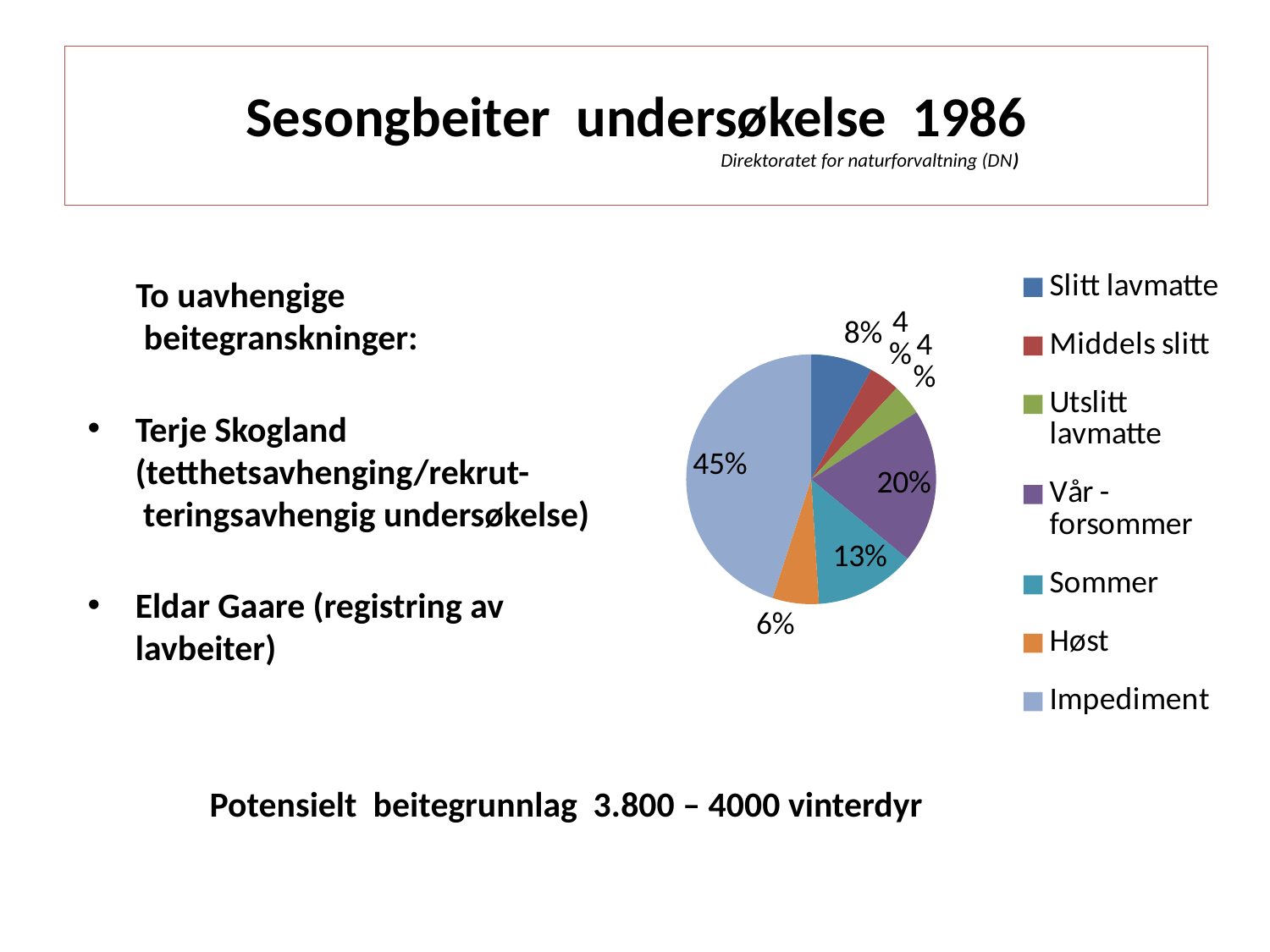
How many categories does the legend list? 7 What is the value shown for Sommer? 13% Which legend entry is shown in orange? Høst Which category has the largest slice of the pie? Impediment What share of the pie does Impediment represent? 45% What is the value shown for Vår - forsommer? 20% What is the value shown for Slitt lavmatte? 8% Which is larger, the Sommer slice or the Høst slice? Sommer What is the combined share of Sommer and Høst? 19% What is the difference between the Impediment slice and the Vår - forsommer slice? 25% What is the value shown for Høst? 6% What type of chart is shown on the slide? pie chart